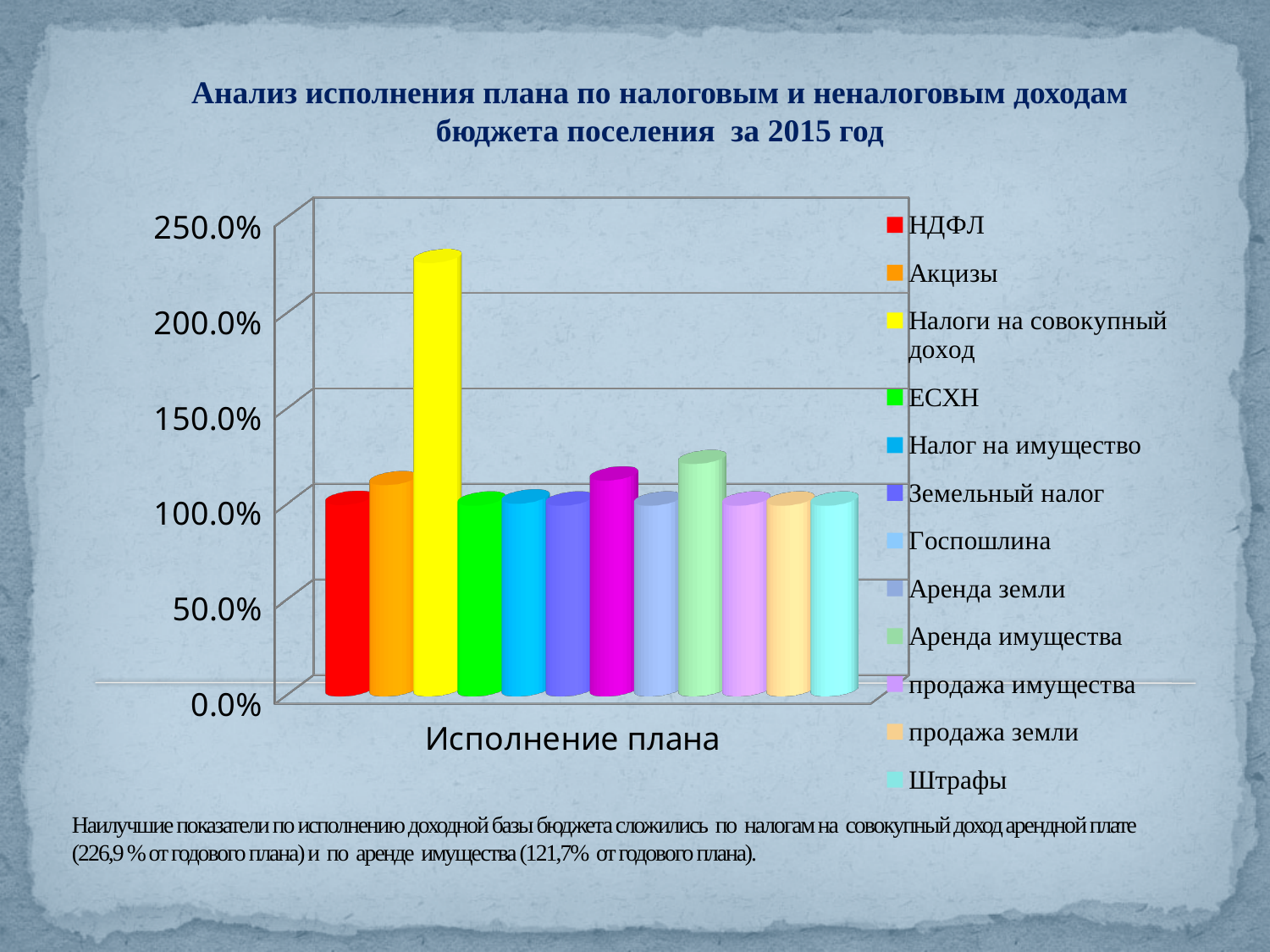
How many series does the legend list? 12 Which is larger, the value for Аренда имущества or the value for Земельный налог? Аренда имущества Is the value for Аренда имущества greater or less than 150.0%? less Is the value for Налоги на совокупный доход greater or less than 200.0%? greater What is the label on the x axis of the chart? Исполнение плана Is the value for Земельный налог greater or less than 150.0%? less Which is larger, the value for Налоги на совокупный доход or the value for Аренда имущества? Налоги на совокупный доход Which series has the highest value? Налоги на совокупный доход How many categories are shown on the x axis? 1 What kind of chart is shown on the slide? bar chart What colour is the bar for Налоги на совокупный доход? yellow